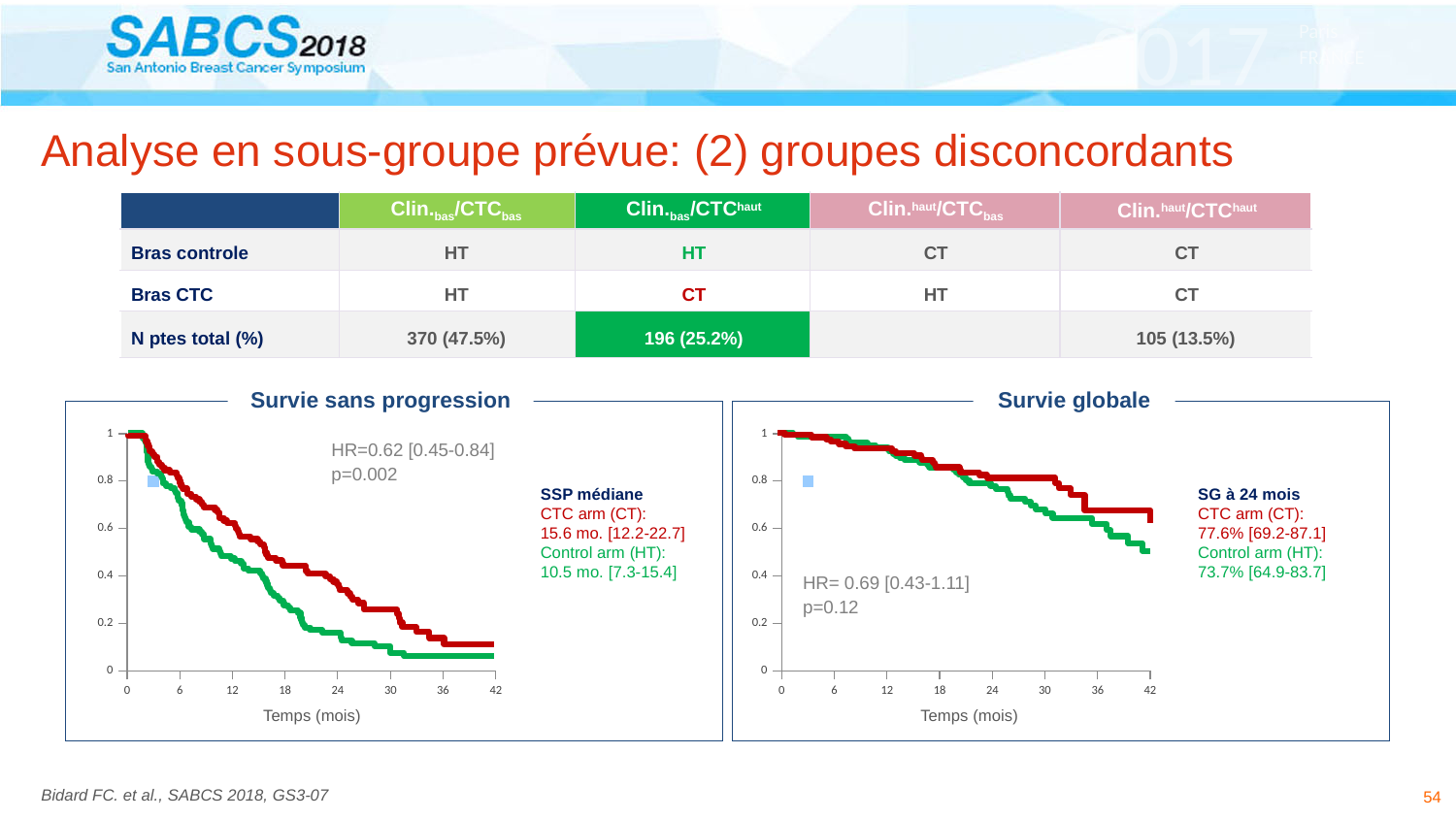
In the 'Survie sans progression' chart, which arm has the longer median PFS? CTC arm (CT) In the 'Survie globale' chart, what is the overall survival at 24 months for the CTC arm (CT)? 77.6% [69.2-87.1] What kind of chart is the 'Survie sans progression' chart? line chart In the 'Survie sans progression' chart, what is the hazard ratio shown? HR=0.62 [0.45-0.84] In the 'Survie sans progression' chart, what is the median PFS for the control arm (HT)? 10.5 mo. [7.3-15.4] In the 'Survie sans progression' chart, what is the difference in median PFS between the CTC arm and the control arm? 5.1 mo. In the 'Survie globale' chart, what is the overall survival at 24 months for the control arm (HT)? 73.7% [64.9-83.7] In the 'Survie globale' chart, do the survival curves rise or fall as time increases? fall In the 'Survie sans progression' chart, what is the p-value shown? p=0.002 In the 'Survie globale' chart, what is the hazard ratio and p-value shown? HR= 0.69 [0.43-1.11], p=0.12 In the 'Survie sans progression' chart, what is the median PFS for the CTC arm (CT)? 15.6 mo. [12.2-22.7] What is the x-axis label on the 'Survie sans progression' chart? Temps (mois)